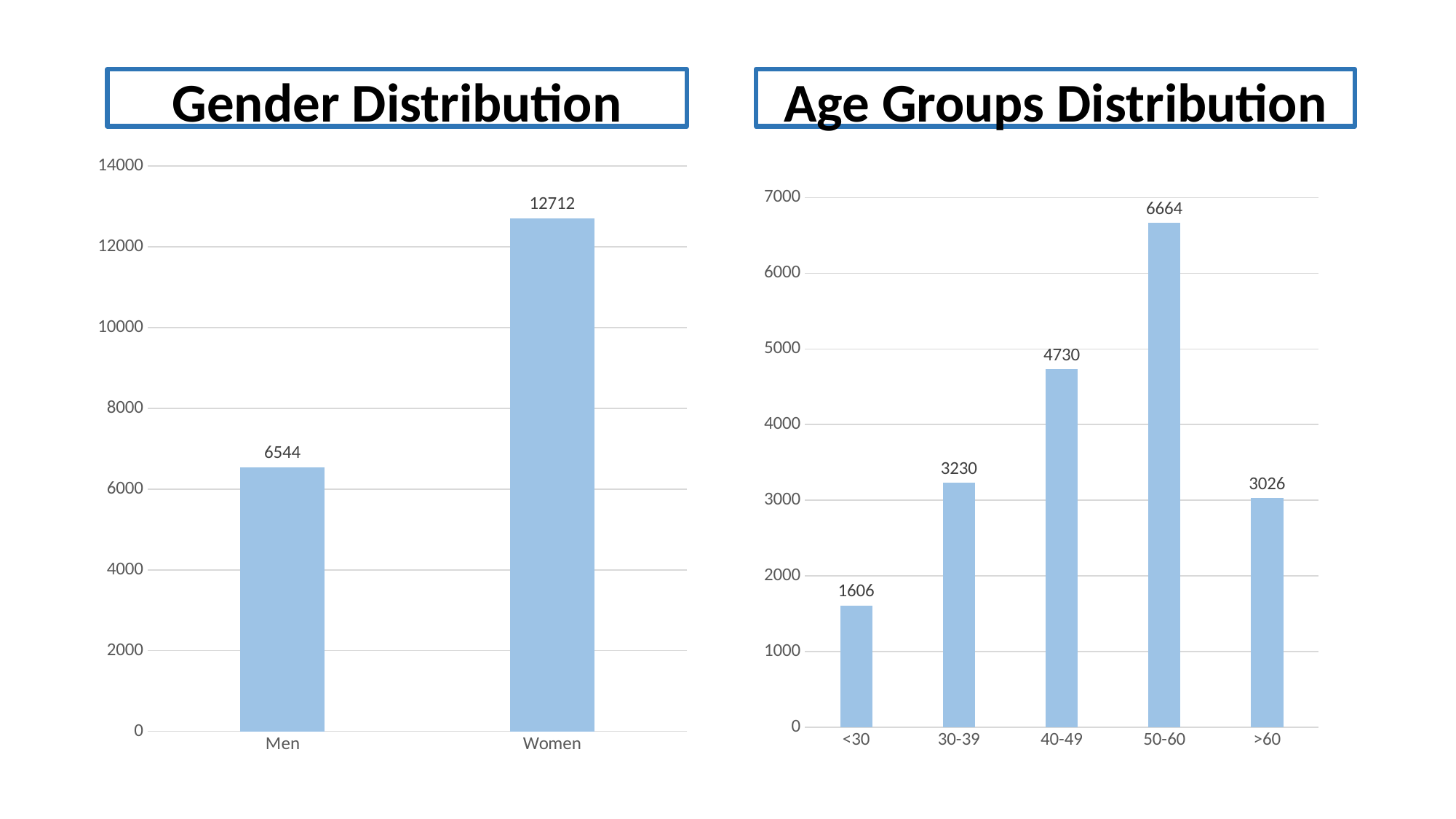
In the Gender Distribution chart, which category has the higher value, Men or Women? Women What kind of chart is the Age Groups Distribution chart? Bar chart In the Gender Distribution chart, what is the value for Women? 12712 In the Gender Distribution chart, what is the difference between the values for Women and Men? 6168 In the Age Groups Distribution chart, what is the value for the <30 age group? 1606 In the Age Groups Distribution chart, what is the difference between the values for 40-49 and 30-39? 1500 In the Age Groups Distribution chart, which age group has the lowest value? <30 In the Age Groups Distribution chart, which age group has the highest value? 50-60 In the Age Groups Distribution chart, what is the value for the 50-60 age group? 6664 In the Age Groups Distribution chart, how many age groups are shown? 5 In the Gender Distribution chart, what is the value for Men? 6544 In the Gender Distribution chart, how many categories are shown? 2